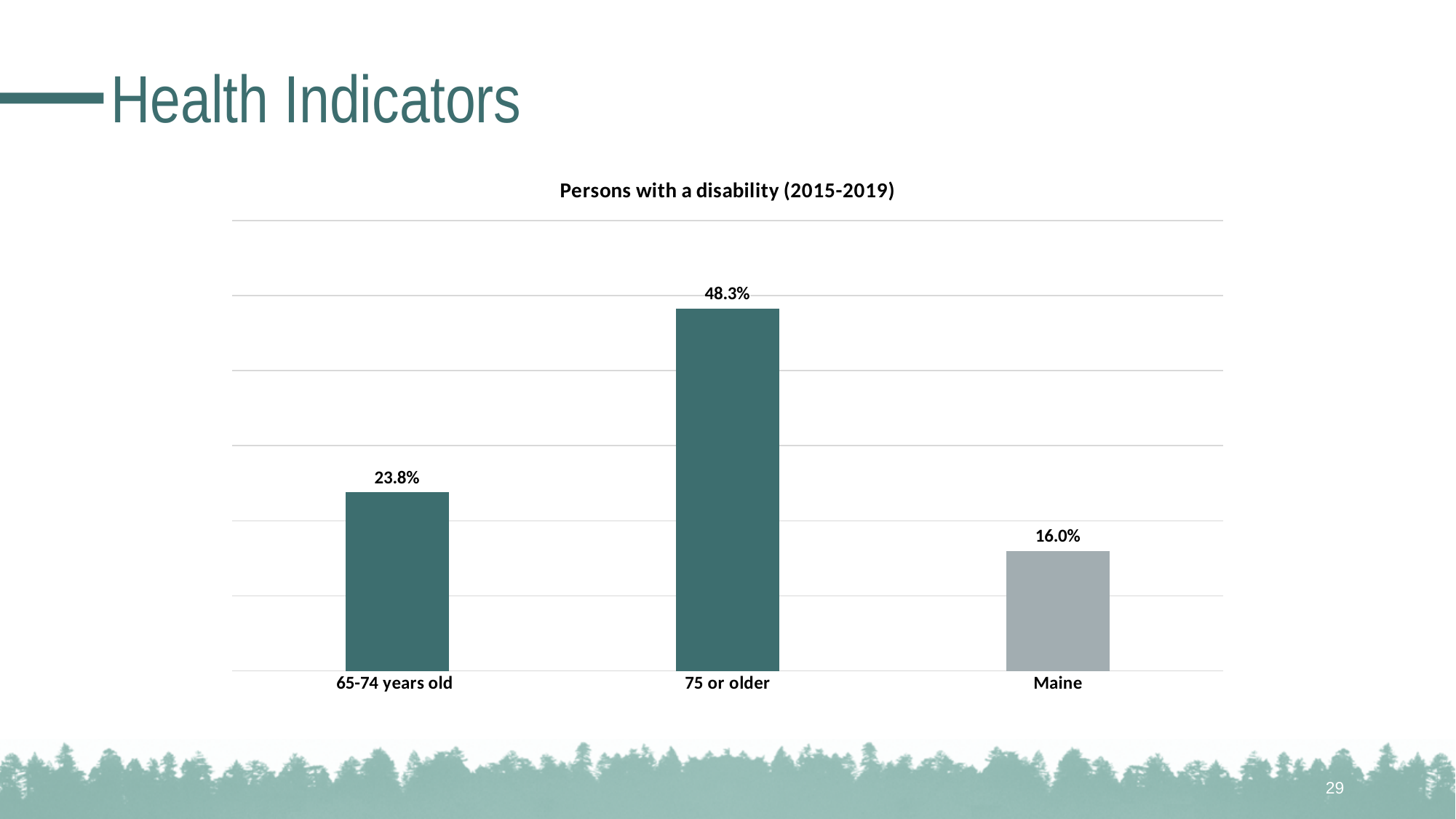
What kind of chart is shown on the slide? Bar chart What is the title of the chart? Persons with a disability (2015-2019) What is the difference between the values for 75 or older and 65-74 years old? 24.5% Which category has the highest value? 75 or older Which category has the lowest value? Maine What is the value for Maine? 16.0% Which bar is coloured grey rather than teal? Maine How many categories are shown in the chart? 3 Which is larger, the value for 65-74 years old or the value for Maine? 65-74 years old What is the difference between the values for 65-74 years old and Maine? 7.8% What is the value for 65-74 years old? 23.8% What is the value for 75 or older? 48.3%